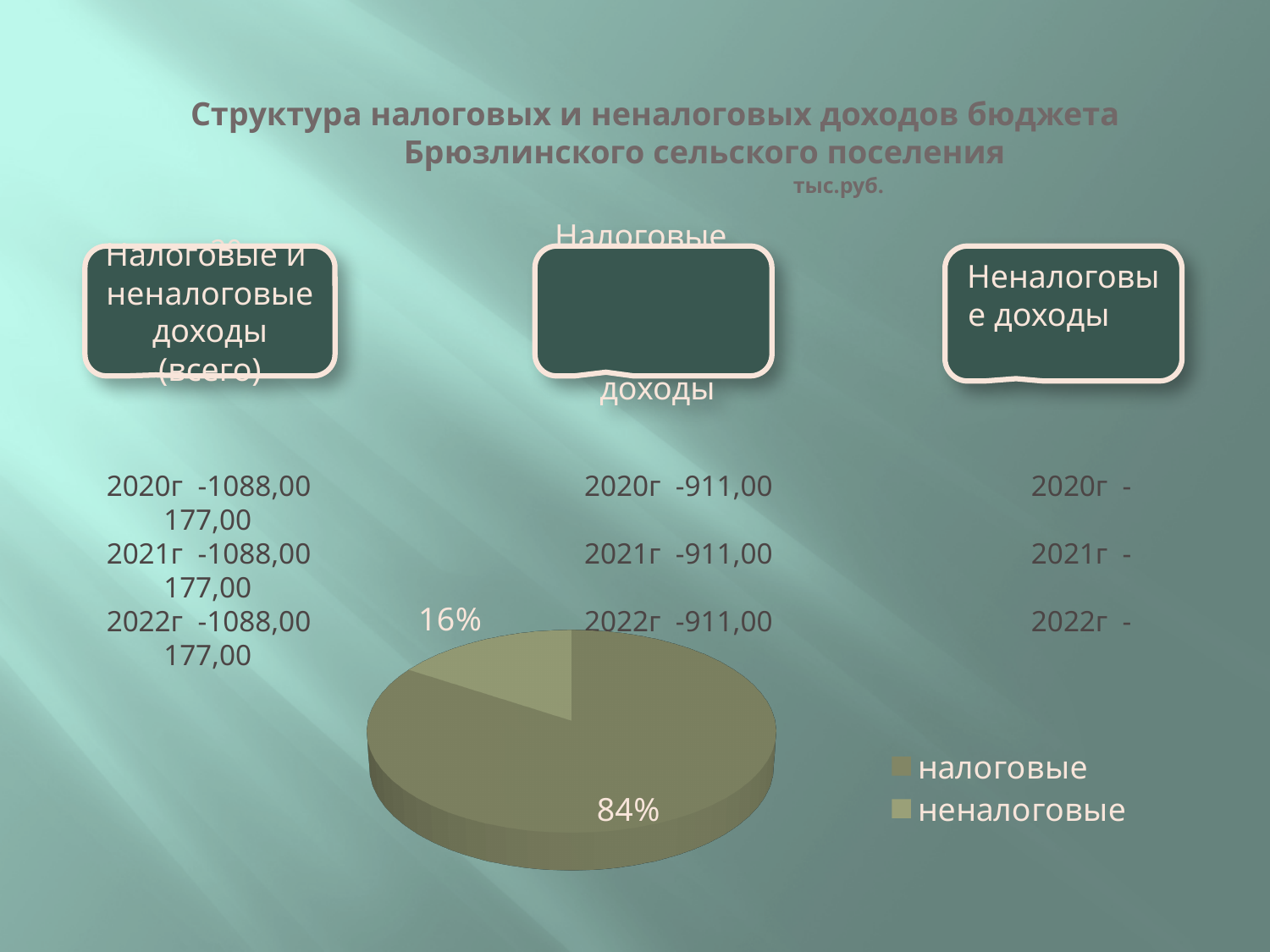
What share of the pie does the "неналоговые" slice represent? 16% How many entries does the legend of the pie chart list? 2 What is the difference in percentage points between the "налоговые" and "неналоговые" slices? 68 Which is larger in the pie chart, the "налоговые" slice or the "неналоговые" slice? налоговые What are the two legend entries of the pie chart? налоговые, неналоговые Which slice of the pie chart is the largest? налоговые How many slices does the pie chart have? 2 Is the share of the "неналоговые" slice greater or less than 20%? less What share of the pie does the "налоговые" slice represent? 84% Which slice of the pie chart is the smallest? неналоговые What kind of chart is shown on the slide? pie chart